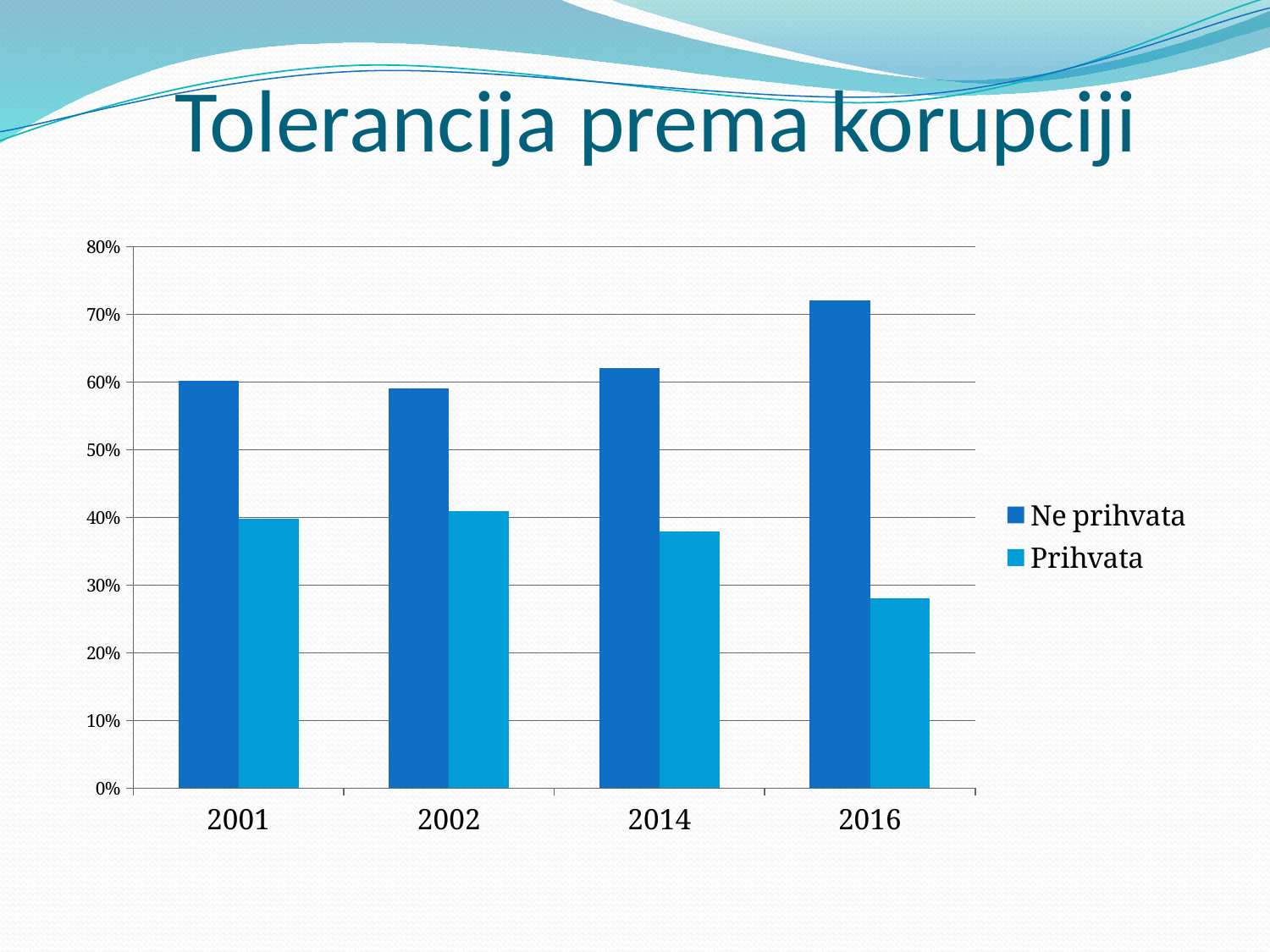
In which year is the Ne prihvata bar the highest? 2016 In which year is the Prihvata bar the lowest? 2016 What is the title of the chart? Tolerancija prema korupciji Which is larger: Ne prihvata in 2001 or Ne prihvata in 2016? Ne prihvata in 2016 Is the value for Prihvata in 2016 greater or less than 30%? less Is the value for Ne prihvata in 2016 greater or less than 70%? greater What kind of chart is shown on the slide? bar chart How many years are shown on the x axis? 4 What are the two series named in the legend? Ne prihvata, Prihvata How many series does the legend list? 2 Is the value for Prihvata in 2014 greater or less than 40%? less Does the Ne prihvata value rise or fall from 2014 to 2016? rise